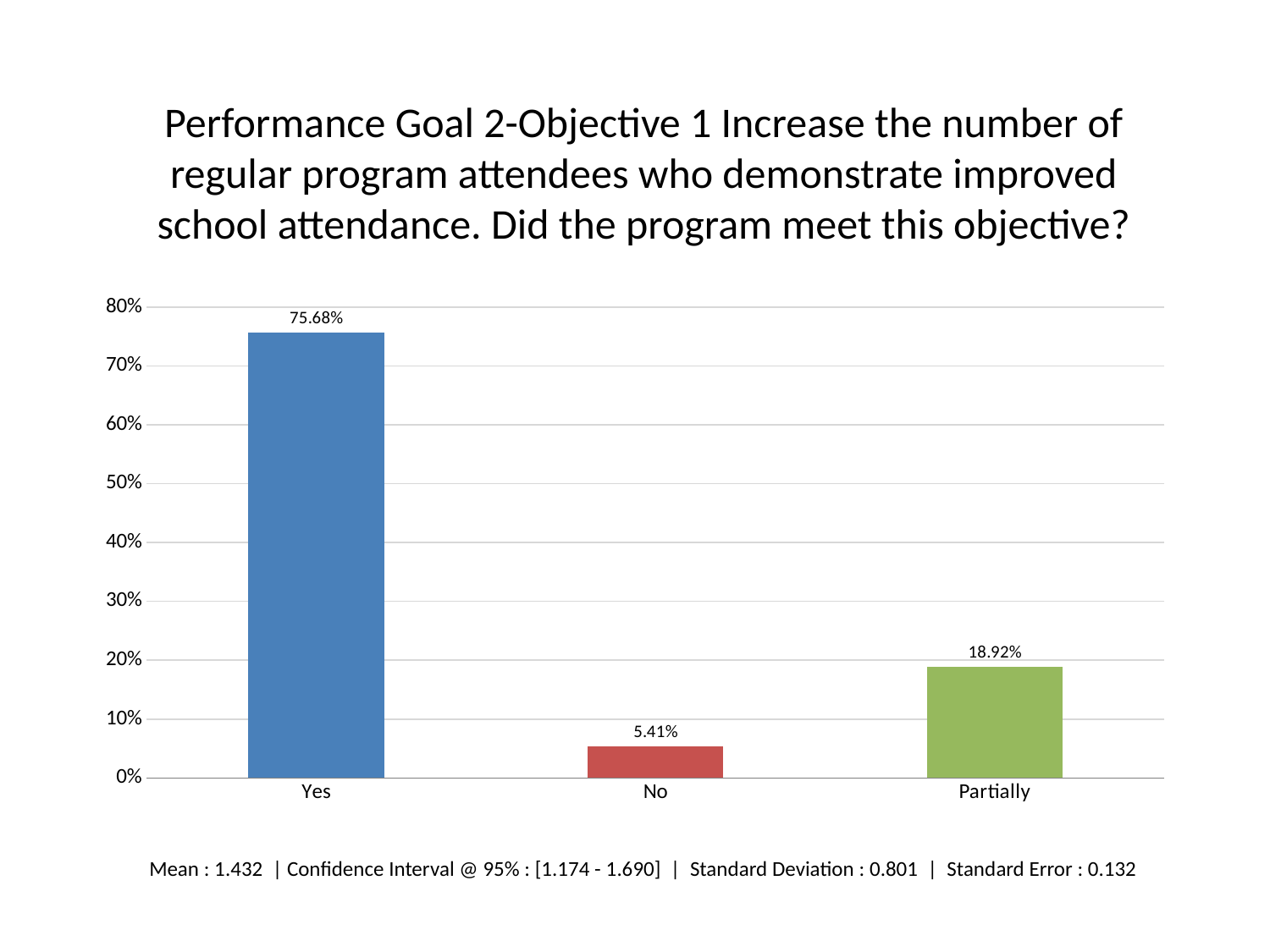
Which is larger, the value for "No" or the value for "Partially"? Partially What percentage of respondents answered "No"? 5.41% Which response category has the lowest percentage? No Is the value for "Yes" greater or less than 70%? greater How many response categories are shown on the x axis? 3 What percentage of respondents answered "Yes"? 75.68% Which response category has the highest percentage? Yes What kind of chart is shown on the slide? Bar chart What is the difference in percentage points between "Yes" and "Partially"? 56.76 What is the difference in percentage points between "Partially" and "No"? 13.51 What is the mean value reported below the chart? 1.432 What percentage of respondents answered "Partially"? 18.92%